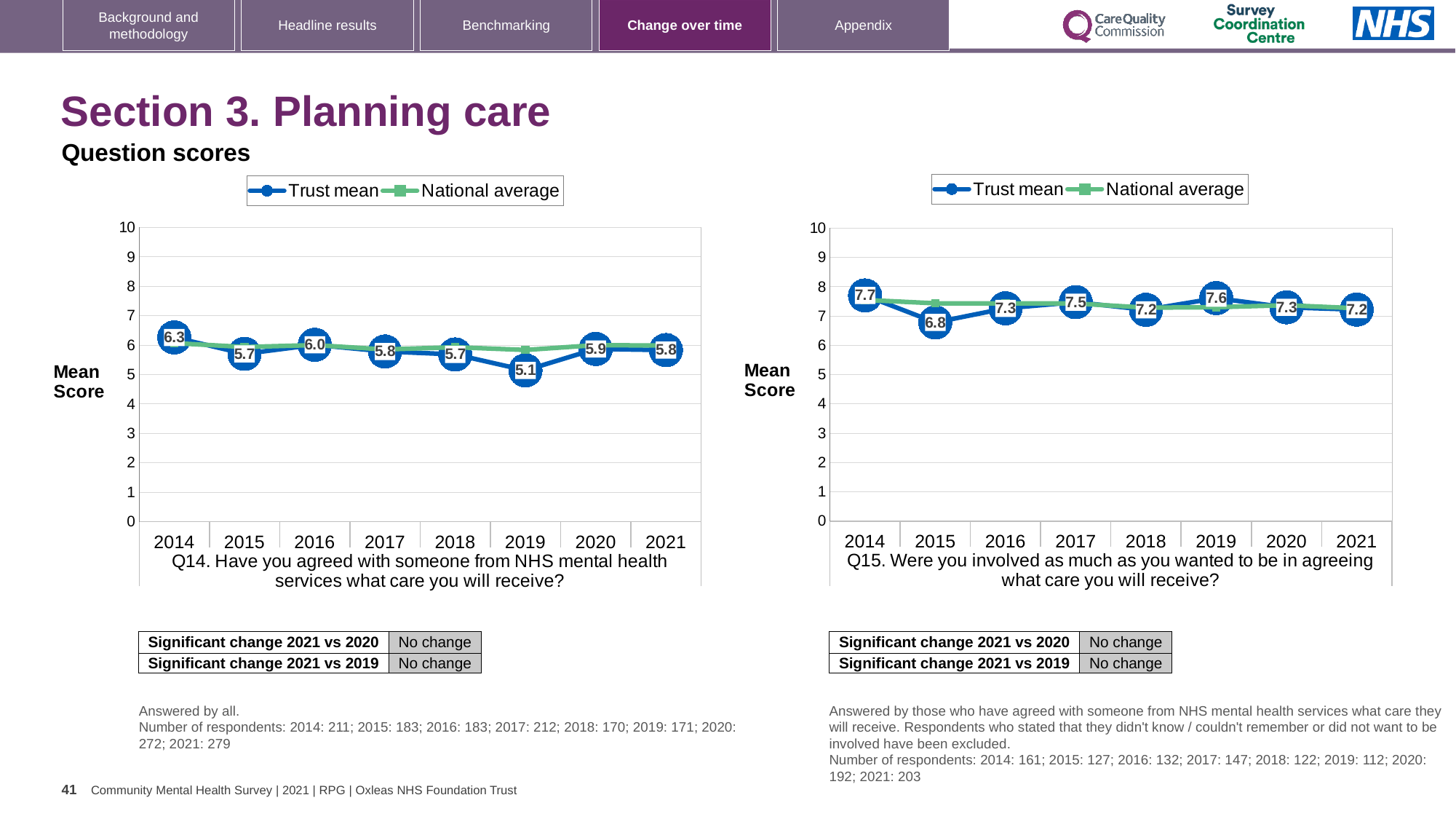
In the Q15 chart on the right, what is the difference between the Trust mean scores for 2014 and 2015? 0.9 In the Q15 chart on the right, what is the Trust mean score for 2021? 7.2 In the Q15 chart on the right, is the Trust mean score for 2019 higher or lower than for 2018? higher In the Q15 chart on the right, which year has the highest Trust mean score? 2014 In the Q14 chart on the left, what is the Trust mean score for 2014? 6.3 In the Q14 chart on the left, what is the Trust mean score for 2019? 5.1 In the Q15 chart on the right, what is the Trust mean score for 2015? 6.8 In the Q14 chart on the left, is the National average for 2019 greater or less than 5? greater In the Q14 chart on the left, what is the difference between the Trust mean scores for 2014 and 2019? 1.2 How many years are plotted on the x axis of the Q14 chart on the left? 8 In the Q14 chart on the left, which year has the lowest Trust mean score? 2019 How many series does the legend of the Q15 chart on the right list? 2